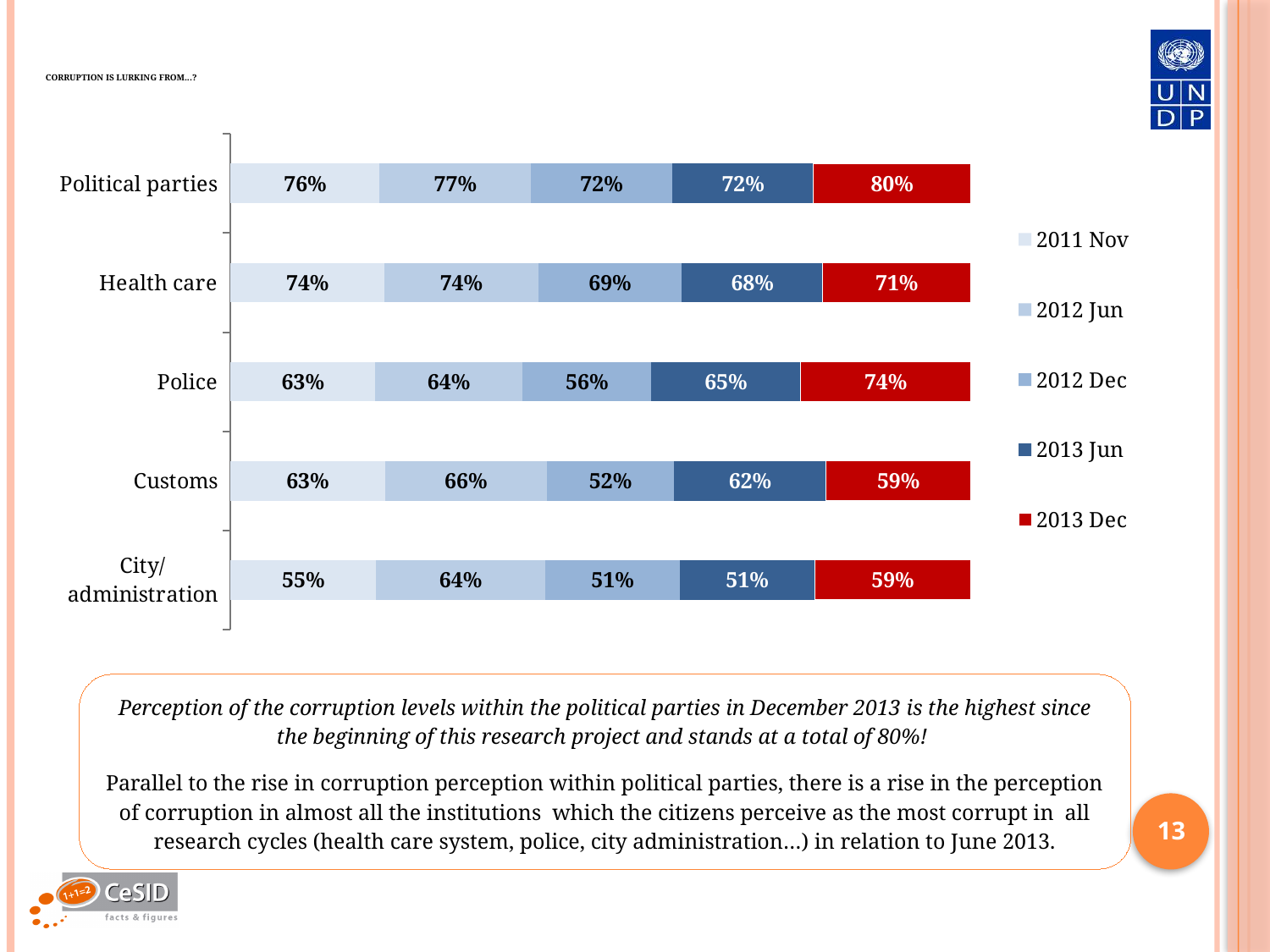
How many series does the legend list? 5 What is the value for Customs in 2012 Jun? 66% What type of chart is shown on the slide? Stacked bar chart What is the value for Political parties in 2013 Dec? 80% What is the value for City/administration in 2011 Nov? 55% How many categories (institutions) are shown on the chart? 5 Which legend entry is shown in red? 2013 Dec What is the value for Police in 2012 Dec? 56% Which category has the lowest value in 2012 Dec? City/administration Which category has the highest value in 2013 Dec? Political parties What is the difference between the Police values for 2013 Dec and 2013 Jun? 9% Which is larger: the Customs value in 2013 Jun or the Customs value in 2013 Dec? 2013 Jun